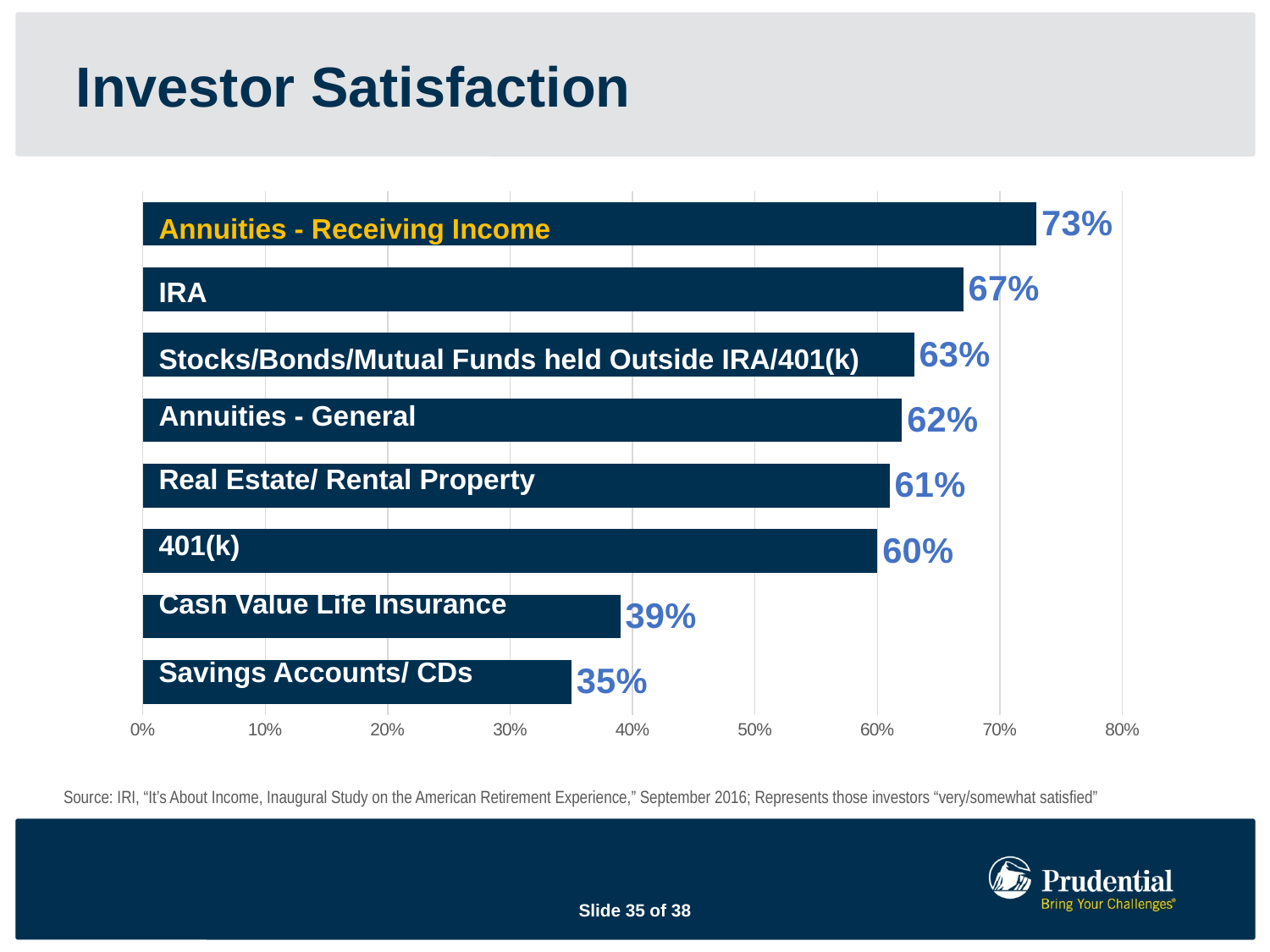
What is the difference between the values for Annuities - Receiving Income and Savings Accounts/ CDs? 38% What is the value for Annuities - Receiving Income? 73% Which is larger, the value for Stocks/Bonds/Mutual Funds held Outside IRA/401(k) or the value for Cash Value Life Insurance? Stocks/Bonds/Mutual Funds held Outside IRA/401(k) What kind of chart is shown on the slide? bar chart What is the difference between the values for IRA and 401(k)? 7% What is the value for Cash Value Life Insurance? 39% What is the value for Real Estate/ Rental Property? 61% What is the title of the slide? Investor Satisfaction Which category has the highest value? Annuities - Receiving Income How many categories are shown in the chart? 8 Which category has the lowest value? Savings Accounts/ CDs Is the value for Annuities - General greater or less than 50%? greater